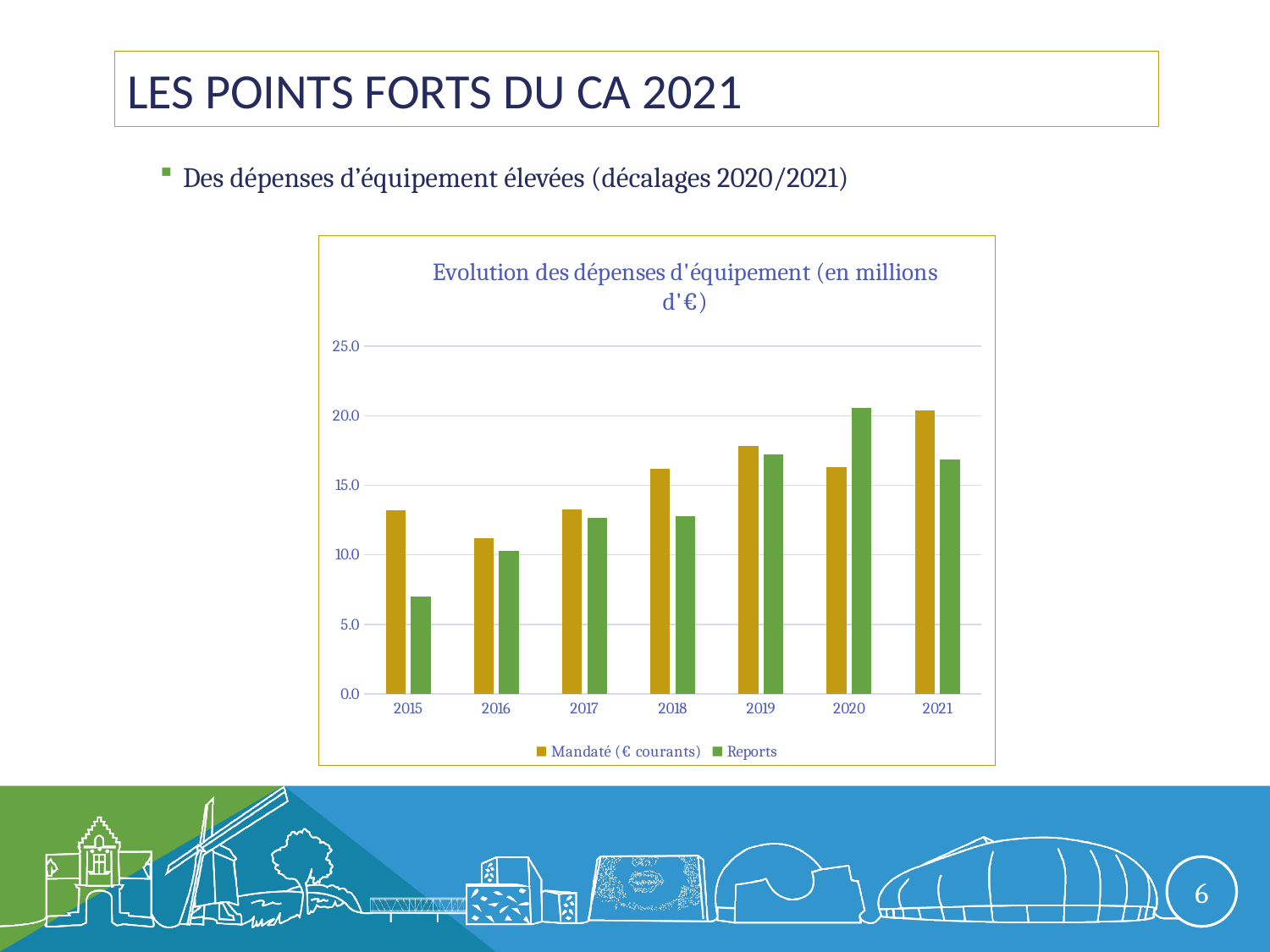
Is the Reports value for 2015 greater or less than 10.0? less In which year is the Reports value highest? 2020 In 2021, which is larger: Mandaté (€ courants) or Reports? Mandaté (€ courants) In 2020, which is larger: Mandaté (€ courants) or Reports? Reports Is the Mandaté (€ courants) value for 2019 greater or less than 15.0? greater Do the Reports values rise or fall from 2015 to 2020? rise How many series does the chart legend list? 2 How many years are shown on the x axis of the chart? 7 In which year is the Mandaté (€ courants) value lowest? 2016 In which year is the Reports value lowest? 2015 What kind of chart is shown on the slide? bar chart In which year is the Mandaté (€ courants) value highest? 2021